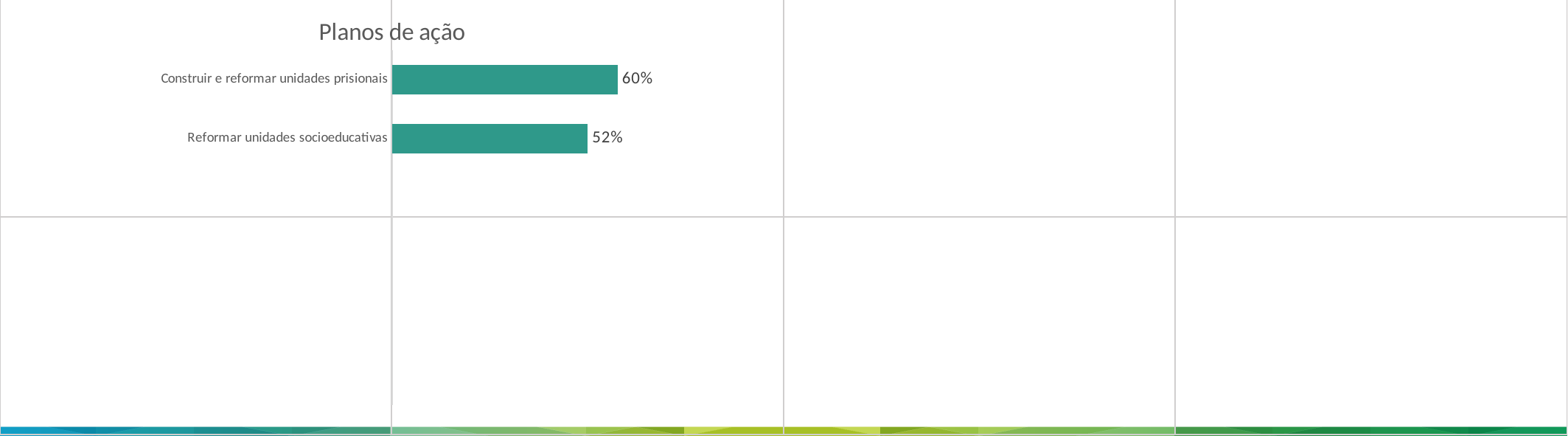
Which category has the lowest value? Reformar unidades socioeducativas What kind of chart is shown on the slide? Bar chart Which is larger: the value for "Construir e reformar unidades prisionais" or for "Reformar unidades socioeducativas"? Construir e reformar unidades prisionais How many categories are shown in the chart? 2 What is the value for "Construir e reformar unidades prisionais"? 60% Which category has the highest value? Construir e reformar unidades prisionais What colour are the bars in the chart? Teal What is the title of the chart? Planos de ação What is the value for "Reformar unidades socioeducativas"? 52% What is the difference between the values for "Construir e reformar unidades prisionais" and "Reformar unidades socioeducativas"? 8%